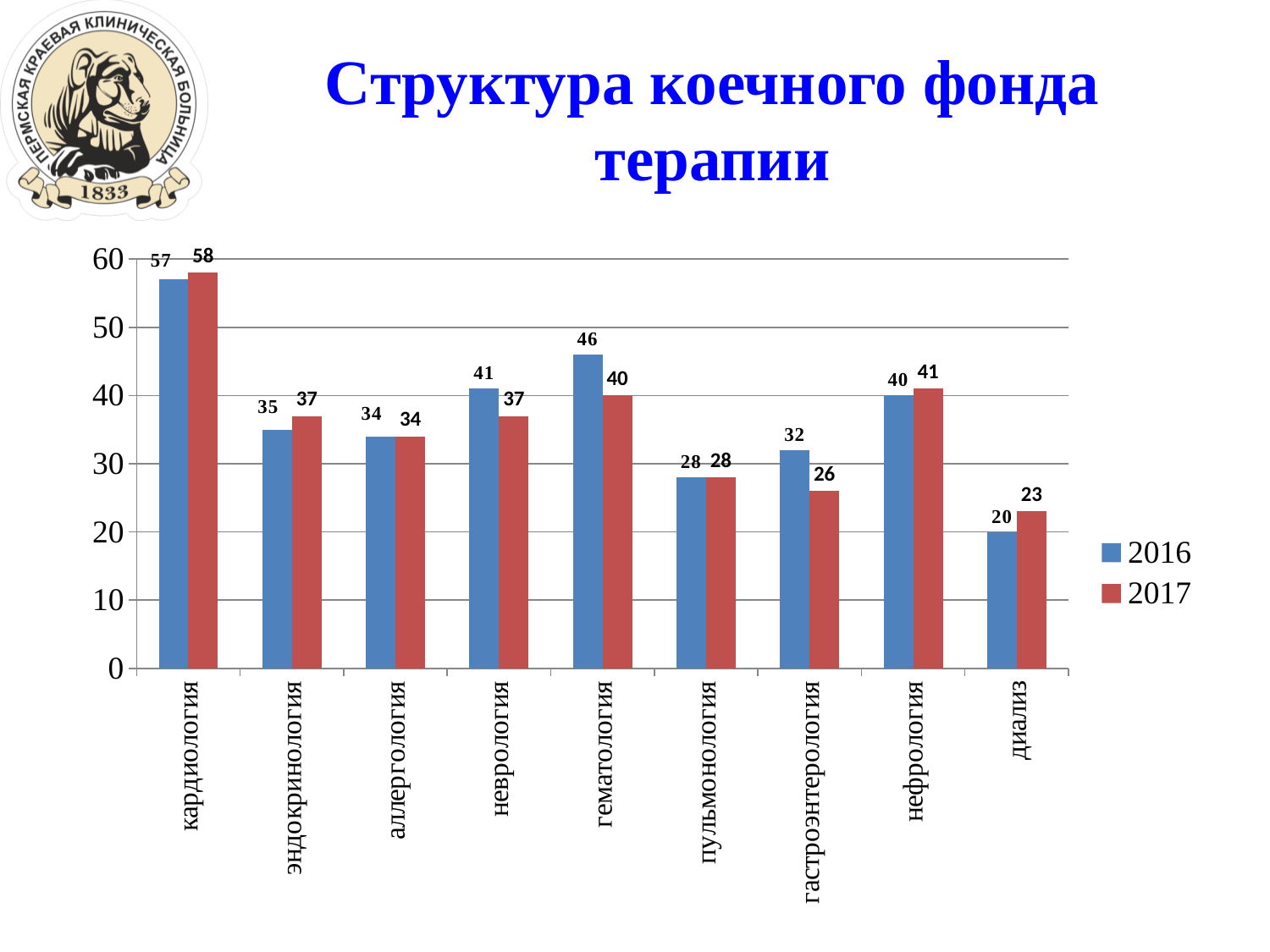
Which category has the lowest value in 2017? диализ What is the value for кардиология in 2017? 58 How many series does the legend list? 2 What kind of chart is shown on the slide? bar chart Which category has the highest value in 2016? кардиология Which colour represents the 2017 series? red Which is larger for гастроэнтерология: the 2016 value or the 2017 value? 2016 What is the title of the slide? Структура коечного фонда терапии What is the difference between the 2016 and 2017 values for гематология? 6 What is the value for гематология in 2016? 46 How many categories are shown on the x axis? 9 What is the value for диализ in 2016? 20